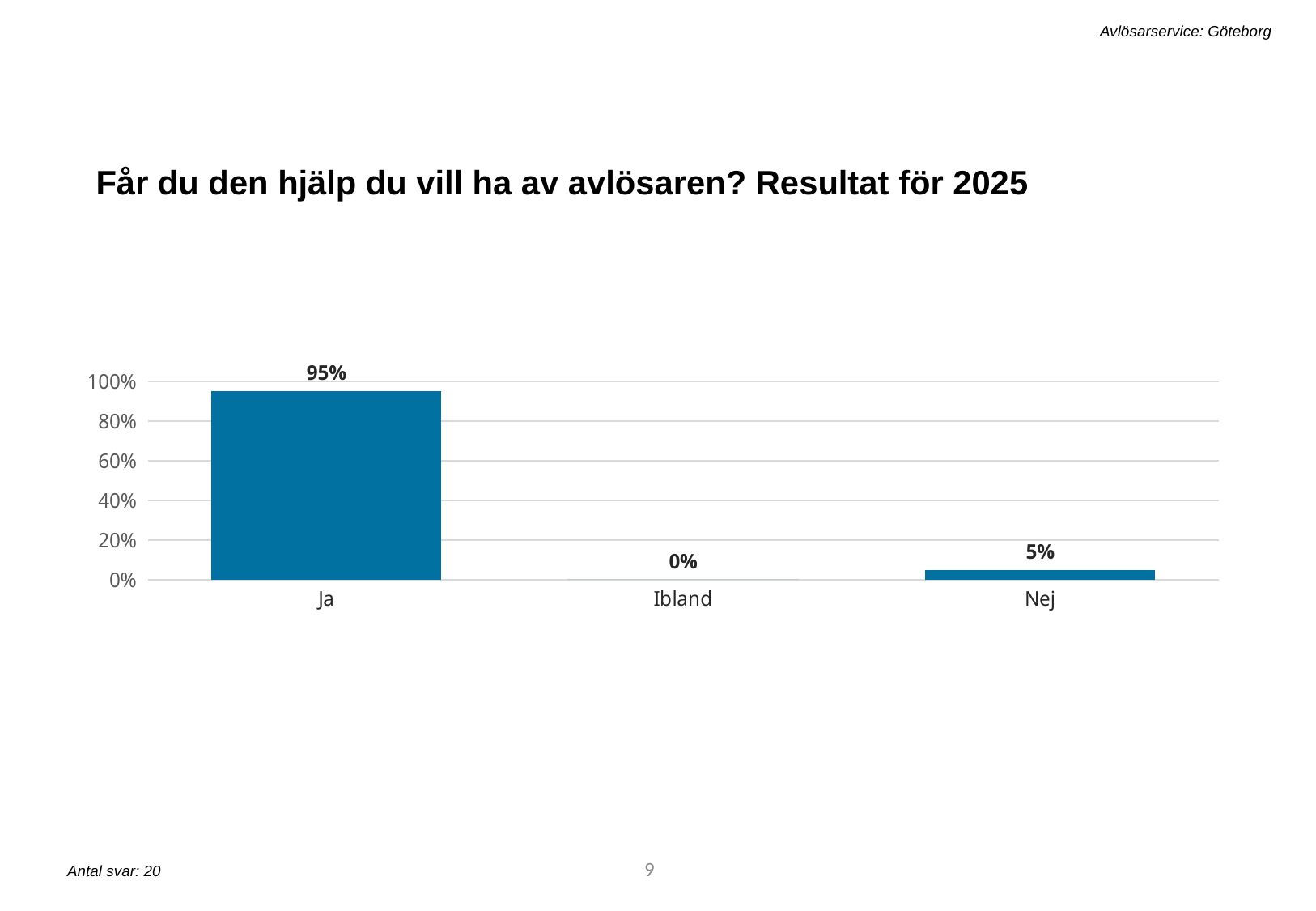
Which is larger, the value for Nej or the value for Ibland? Nej Is the value for Ja greater or less than 80%? greater What is the value for Ibland? 0% What is the value for Ja? 95% Which category has the lowest value? Ibland What is the value for Nej? 5% Which category has the highest value? Ja What kind of chart is shown on the slide? Bar chart What is the title of the chart? Får du den hjälp du vill ha av avlösaren? Resultat för 2025 How many responses (Antal svar) does the slide report? 20 What is the difference between the values for Ja and Nej? 90% How many categories are shown on the x axis? 3